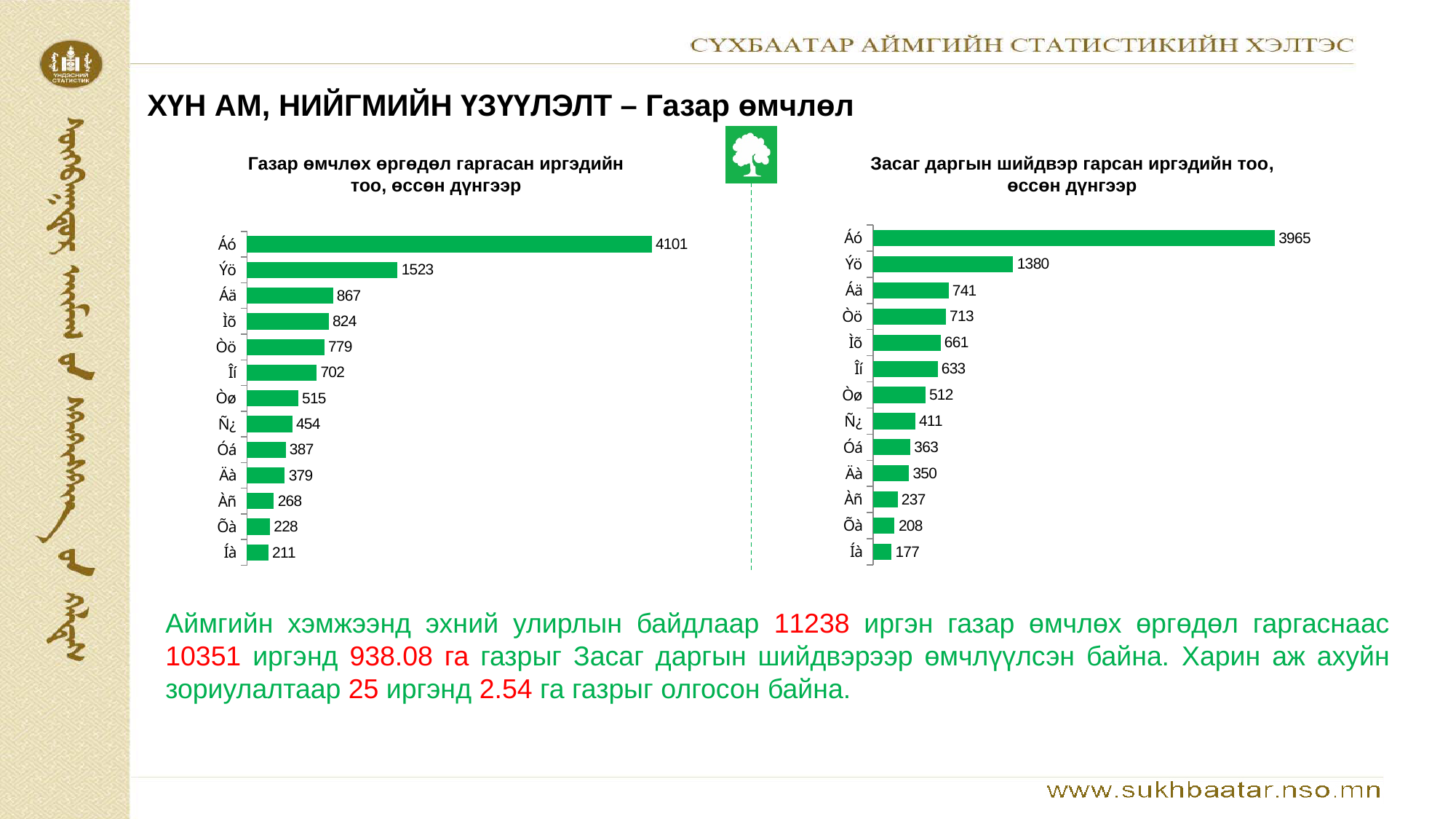
What type of chart is the left chart? Bar chart What is the title of the right chart? Засаг даргын шийдвэр гарсан иргэдийн тоо, өссөн дүнгээр In the left chart, which is larger, the value for Òö or the value for Îí? Òö In the left chart, which category has the lowest value? Íà In the left chart, what is the difference between the values for Áó and Ýö? 2578 In the right chart, which category has the highest value? Áó How many categories are shown in the right chart? 13 In the right chart, what is the value for the lowest category Íà? 177 In the left chart, what is the value for the top category Áó? 4101 In the left chart, what is the value for Õà? 228 In the right chart, what is the value for Ýö? 1380 In the right chart, what is the difference between the values for Áä and Òö? 28